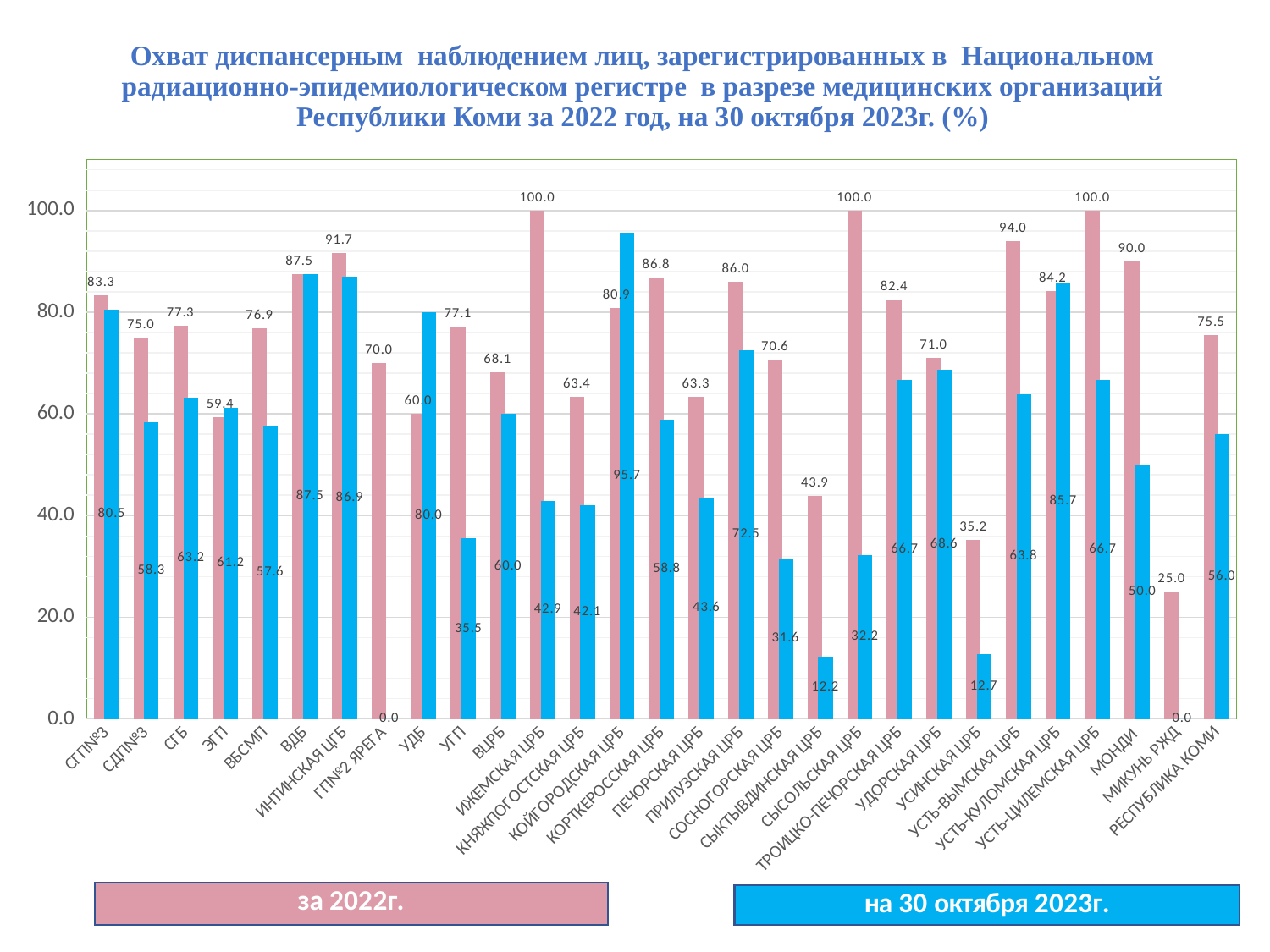
For УДБ, which series has the larger value: 'за 2022г.' or 'на 30 октября 2023г.'? на 30 октября 2023г. What is the value for УСИНСКАЯ ЦРБ in the 'на 30 октября 2023г.' series? 12.7 Which organisation has the highest value in the 'на 30 октября 2023г.' series? КОЙГОРОДСКАЯ ЦРБ What is the value for ИНТИНСКАЯ ЦГБ in the 'за 2022г.' series? 91.7 What is the value for КОРТКЕРОССКАЯ ЦРБ in the 'на 30 октября 2023г.' series? 58.8 What is the difference between the 'за 2022г.' and 'на 30 октября 2023г.' values for СЫСОЛЬСКАЯ ЦРБ? 67.8 What is the value for РЕСПУБЛИКА КОМИ in the 'за 2022г.' series? 75.5 Which organisation has the lowest value in the 'за 2022г.' series? МИКУНЬ РЖД How many series does the legend list? 2 How many organisations (categories) are shown on the x axis? 29 Which series is shown in blue according to the legend? на 30 октября 2023г. What kind of chart is shown on the slide? Bar chart